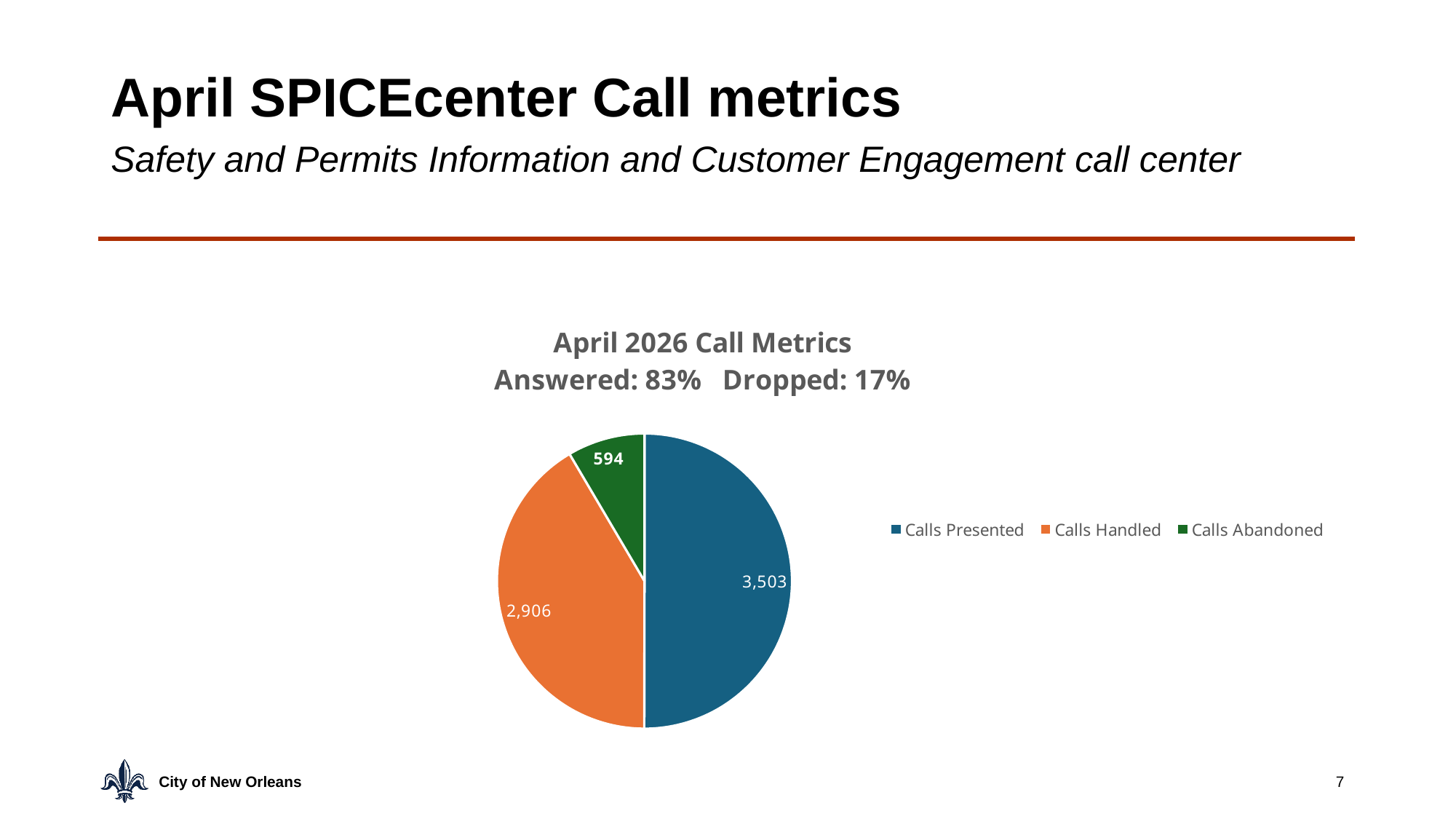
Which category has the smallest slice of the pie? Calls Abandoned How many slices does the pie chart have? 3 What is the title of the chart? April 2026 Call Metrics Answered: 83% Dropped: 17% What is the difference between Calls Presented and Calls Handled? 597 Which is larger, Calls Handled or Calls Abandoned? Calls Handled What is the value for Calls Handled? 2,906 What type of chart is shown on the slide? Pie chart What is the difference between Calls Handled and Calls Abandoned? 2,312 How many entries does the legend list? 3 What is the value for Calls Abandoned? 594 Which category has the largest slice of the pie? Calls Presented What is the value for Calls Presented? 3,503